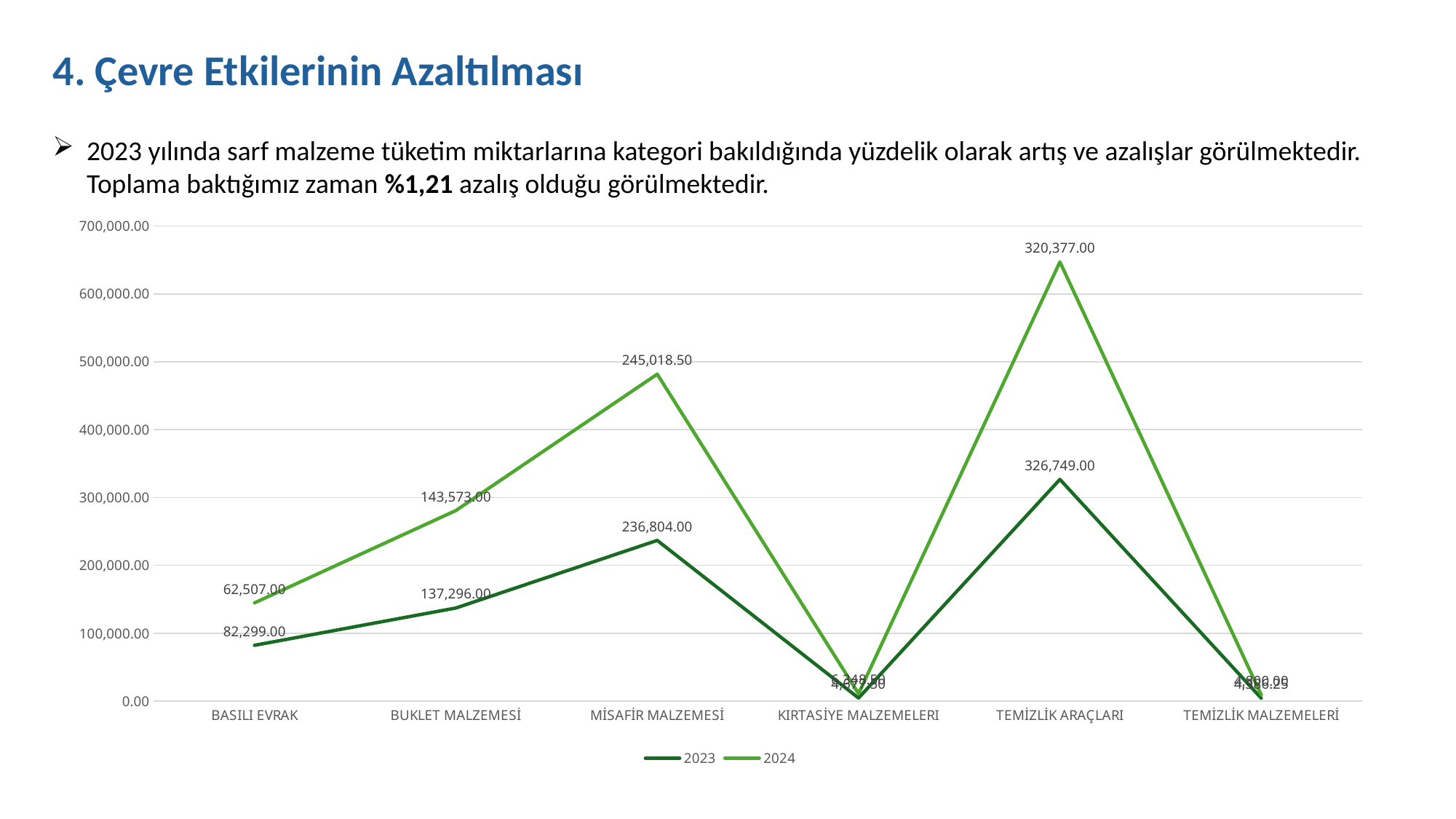
What is the 2023 value for BASILI EVRAK? 82,299.00 Which category has the highest value in the 2023 series? TEMİZLİK ARAÇLARI What kind of chart is shown on the slide? line chart What is the difference between the 2023 and 2024 values for BASILI EVRAK? 19,792.00 What is the 2024 value for TEMİZLİK ARAÇLARI? 320,377.00 Does the 2024 line rise or fall from MİSAFİR MALZEMESİ to KIRTASİYE MALZEMELERİ? fall How many categories are shown on the x axis? 6 What is the 2023 value for BUKLET MALZEMESİ? 137,296.00 For BUKLET MALZEMESİ, which series has the larger value, 2023 or 2024? 2024 What are the two entries in the legend? 2023 and 2024 What is the 2024 value for MİSAFİR MALZEMESİ? 245,018.50 How many series does the legend list? 2